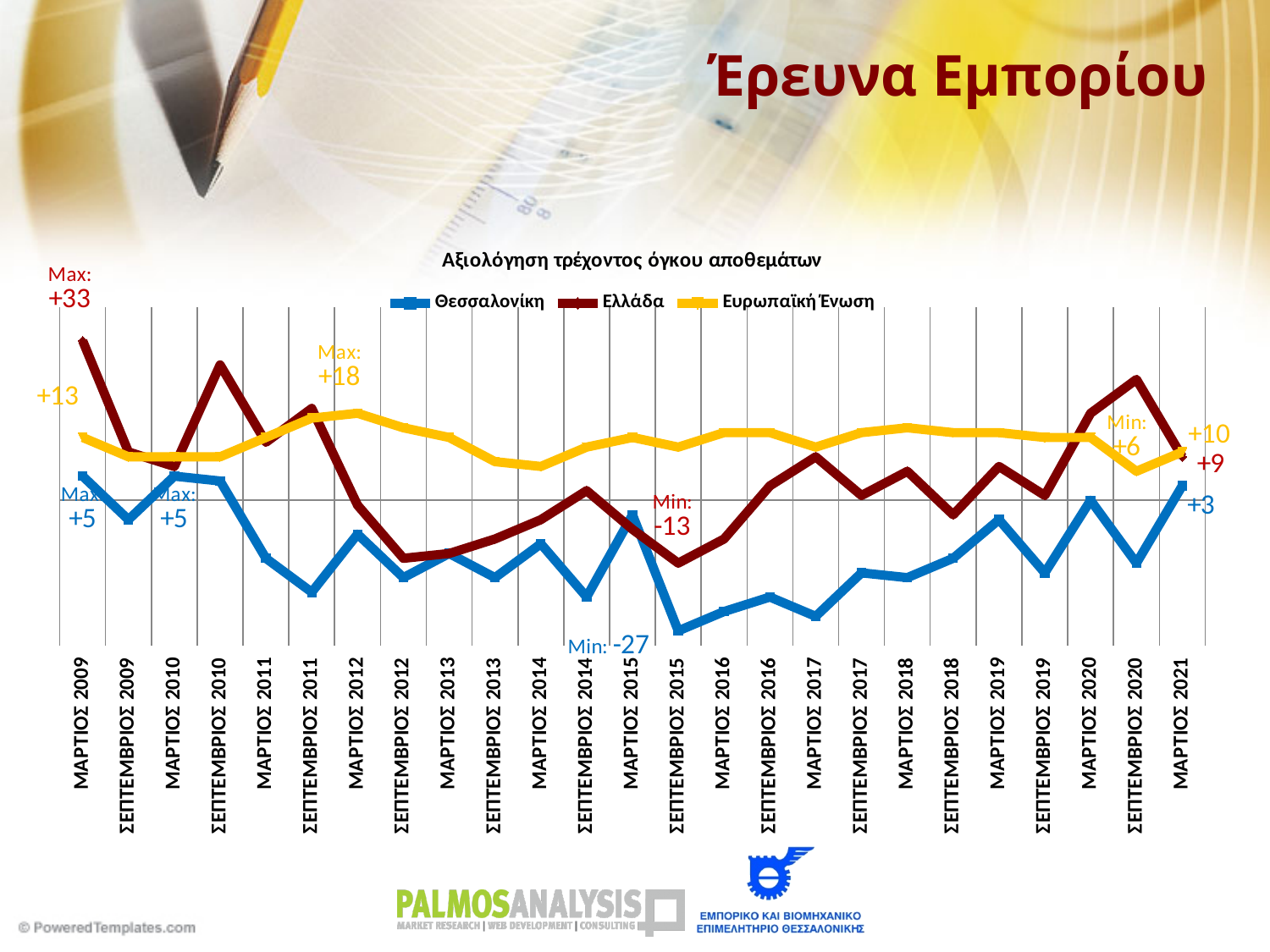
What is the title of the chart? Αξιολόγηση τρέχοντος όγκου αποθεμάτων What is the minimum value labelled for the Θεσσαλονίκη series? -27 What is the maximum value labelled for the Ευρωπαϊκή Ένωση series? +18 What is the value for Ευρωπαϊκή Ένωση at ΜΑΡΤΙΟΣ 2021? +10 What is the difference between the Ελλάδα value and the Θεσσαλονίκη value at ΜΑΡΤΙΟΣ 2021? 6 What is the value for Ελλάδα at ΜΑΡΤΙΟΣ 2021? +9 Which series has the higher value at ΜΑΡΤΙΟΣ 2009, Ελλάδα or Ευρωπαϊκή Ένωση? Ελλάδα What is the value for Θεσσαλονίκη at ΜΑΡΤΙΟΣ 2021? +3 How many series does the legend list? 3 What is the maximum value labelled for the Ελλάδα series? +33 What is the minimum value labelled for the Ελλάδα series? -13 What kind of chart is shown on the slide? line chart